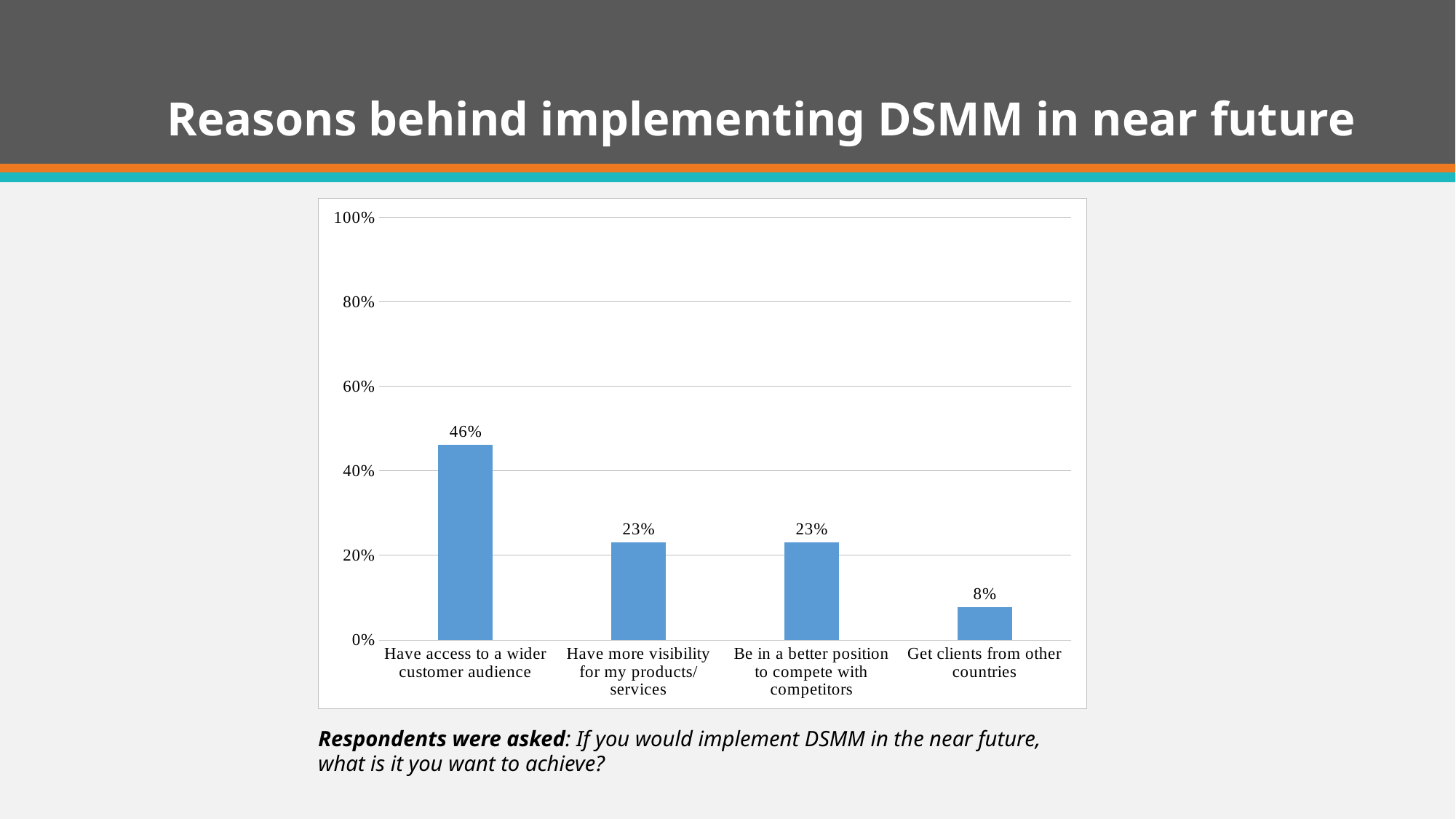
Which is larger: the value for "Be in a better position to compete with competitors" or for "Get clients from other countries"? Be in a better position to compete with competitors Which reason has the lowest percentage? Get clients from other countries What is the value for "Get clients from other countries"? 8% What percentage of respondents chose "Have access to a wider customer audience"? 46% What is the difference between "Have access to a wider customer audience" and "Be in a better position to compete with competitors"? 23% What is the difference between "Have more visibility for my products/ services" and "Get clients from other countries"? 15% What kind of chart is shown on the slide? Bar chart How many reasons (categories) are shown in the chart? 4 What is the title of the slide containing the chart? Reasons behind implementing DSMM in near future Is the value for "Have access to a wider customer audience" greater or less than 40%? greater Which reason has the highest percentage? Have access to a wider customer audience What is the value for "Have more visibility for my products/ services"? 23%